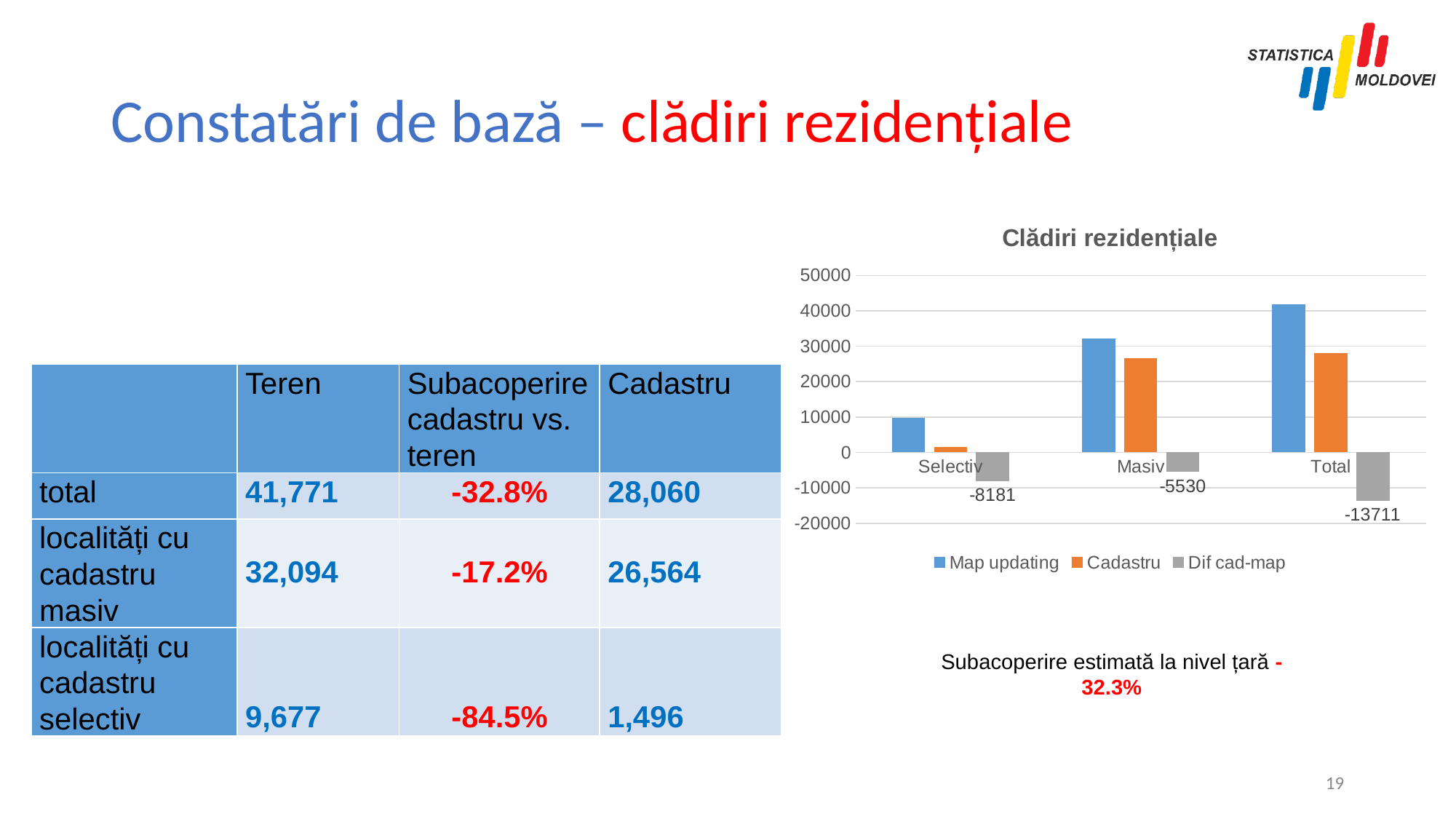
For Selectiv, which is larger: the Map updating value or the Cadastru value? Map updating What is the Dif cad-map value for Total? -13711 How many categories are shown on the x axis of the chart? 3 What kind of chart is shown on the slide? bar chart Is the Map updating value for Total greater or less than 30000? greater How many series does the chart legend list? 3 What is the difference between the Dif cad-map values for Selectiv and Masiv? 2651 What is the Dif cad-map value for Masiv? -5530 Is the Cadastru value for Selectiv greater or less than 10000? less Which category has the lowest Dif cad-map value? Total What is the title of the chart? Clădiri rezidențiale What is the Dif cad-map value for Selectiv? -8181